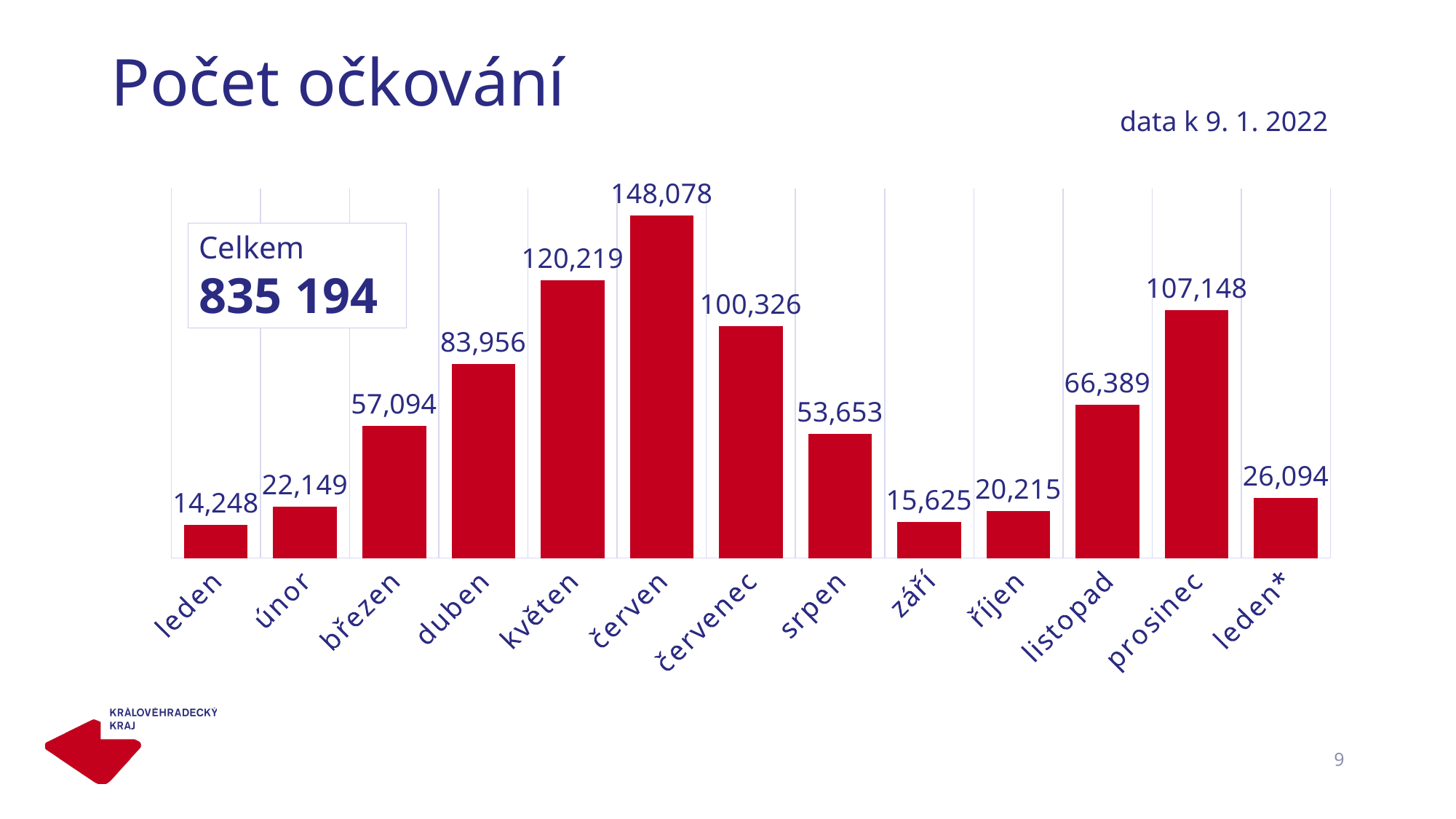
What total (Celkem) is shown in the box on the chart? 835 194 How many bars are shown in the chart? 13 What is the value for leden*? 26,094 What is the value for červen? 148,078 Which month has the highest value? červen Which month has the lowest value? leden What is the value for prosinec? 107,148 What is the difference between the values for prosinec and listopad? 40,759 What is the difference between the values for červen and květen? 27,859 Which is larger, the value for září or the value for říjen? říjen Which is larger, the value for duben or the value for červenec? červenec What kind of chart is shown on the slide? bar chart